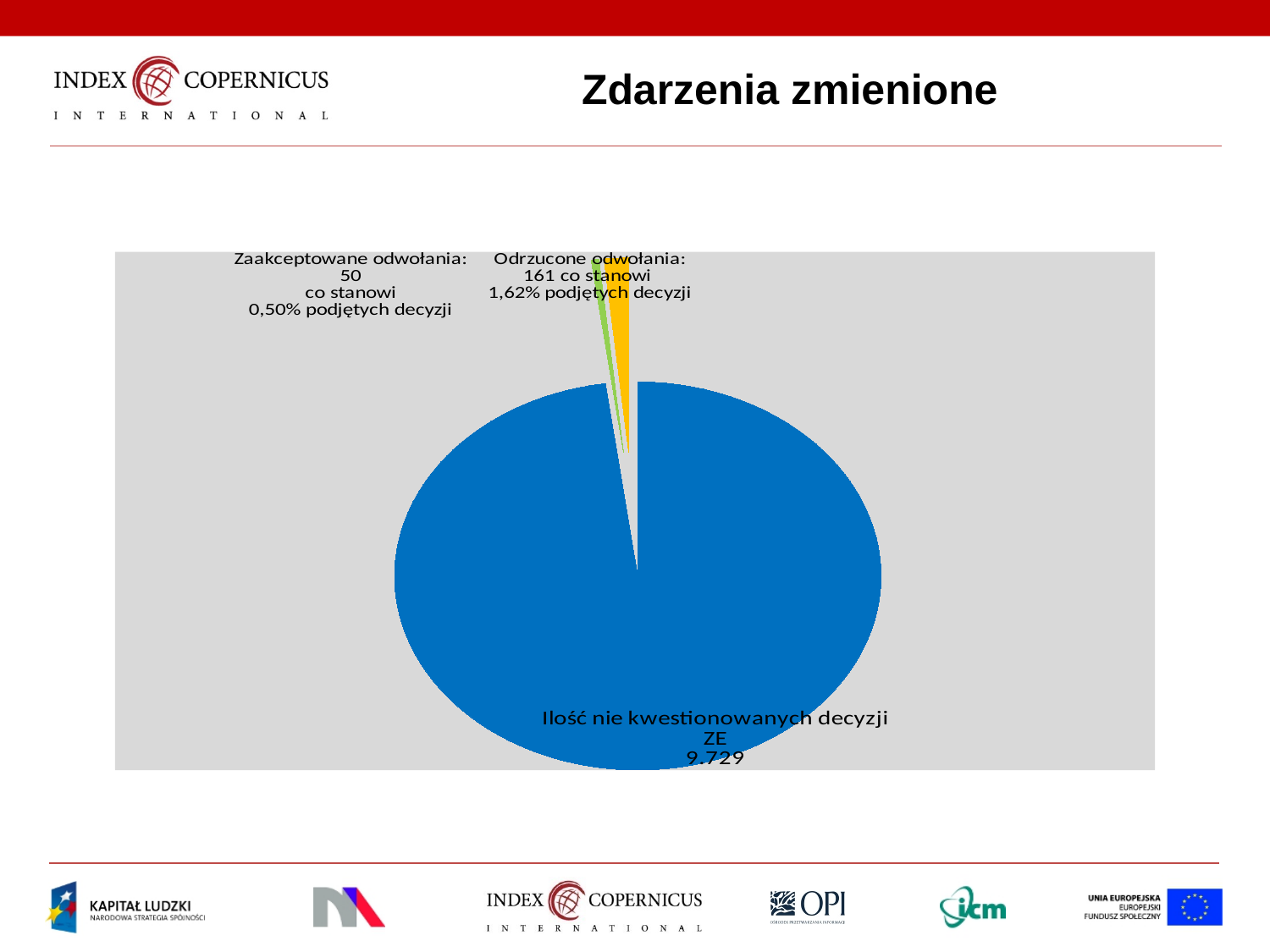
What is the title of the slide containing the pie chart? Zdarzenia zmienione Which slice of the pie chart is the largest? Ilość nie kwestionowanych decyzji ZE What kind of chart is shown on the slide? pie chart What share of the decisions do "Odrzucone odwołania" represent, as printed on the slide? 1,62% What is the difference between the values for "Odrzucone odwołania" and "Zaakceptowane odwołania"? 111 How many slices does the pie chart have? 3 What is the value for "Zaakceptowane odwołania"? 50 What is the value for "Odrzucone odwołania"? 161 What share of the decisions do "Zaakceptowane odwołania" represent, as printed on the slide? 0,50% What is the value for "Ilość nie kwestionowanych decyzji ZE"? 9.729 Which slice of the pie chart is the smallest? Zaakceptowane odwołania Which is larger, "Odrzucone odwołania" or "Zaakceptowane odwołania"? Odrzucone odwołania